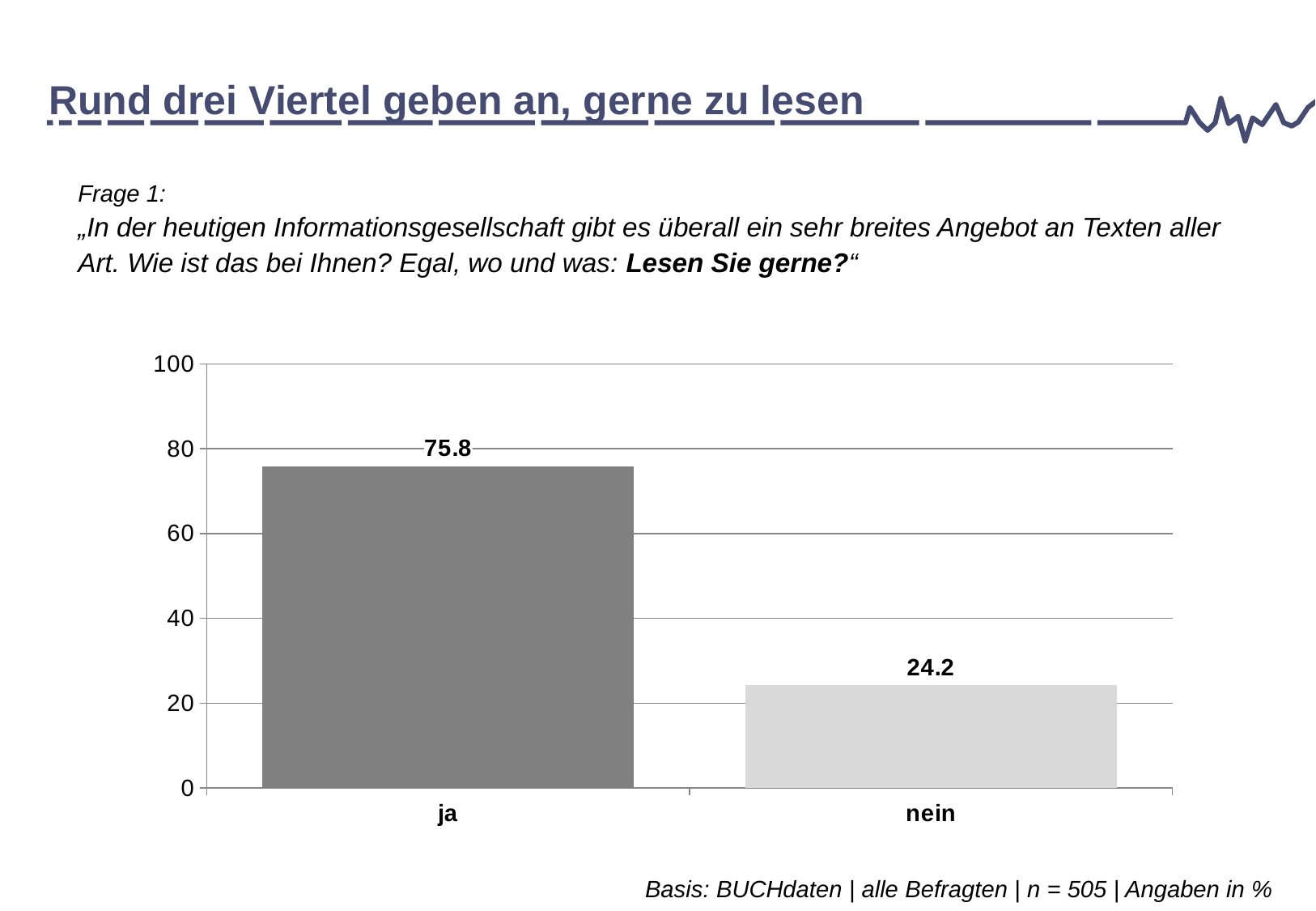
According to the note below the chart, how many respondents (n) form the basis of the data? 505 How many categories are shown on the x axis? 2 What is the value for "nein"? 24.2 What kind of chart is shown on the slide? bar chart What is the highest tick value shown on the y axis? 100 What is the value for "ja"? 75.8 Which category has the lowest value? nein What is the difference between the values for "ja" and "nein"? 51.6 Is the value for "ja" greater or less than 60? greater Is the value for "nein" greater or less than 40? less Which category has the highest value? ja Which is larger, the value for "ja" or the value for "nein"? ja